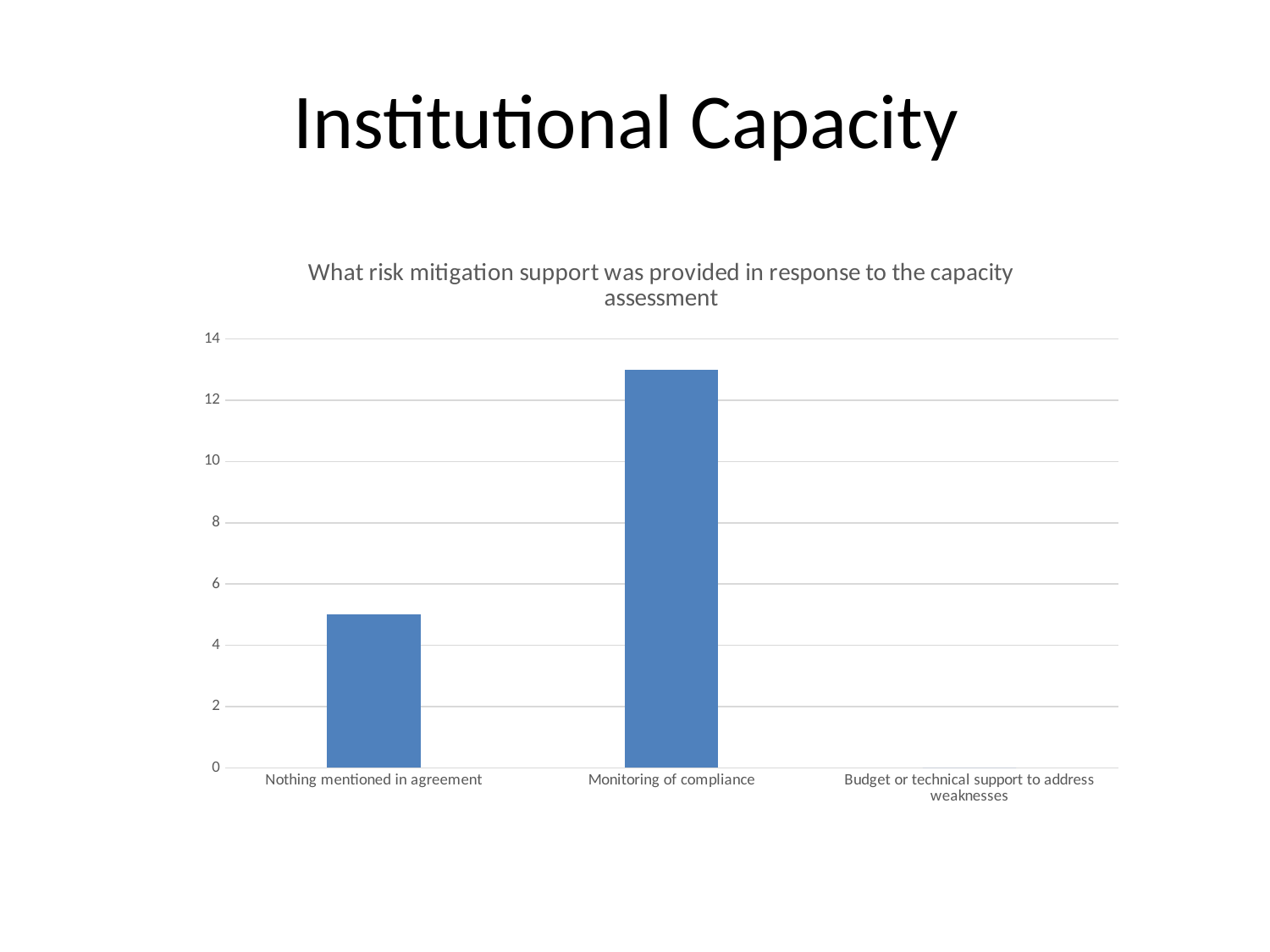
Is the value for Nothing mentioned in agreement greater or less than 4? greater What is the highest value shown on the y axis of the chart? 14 Which category has the lowest value? Budget or technical support to address weaknesses What is the title of the chart? What risk mitigation support was provided in response to the capacity assessment Is the value for Monitoring of compliance greater or less than 14? less Which is larger, the value for Nothing mentioned in agreement or the value for Monitoring of compliance? Monitoring of compliance Is the value for Monitoring of compliance greater or less than 12? greater What kind of chart is shown on the slide? bar chart How many categories are shown on the x axis of the chart? 3 What is the value for Budget or technical support to address weaknesses? 0 Which category has the highest value? Monitoring of compliance